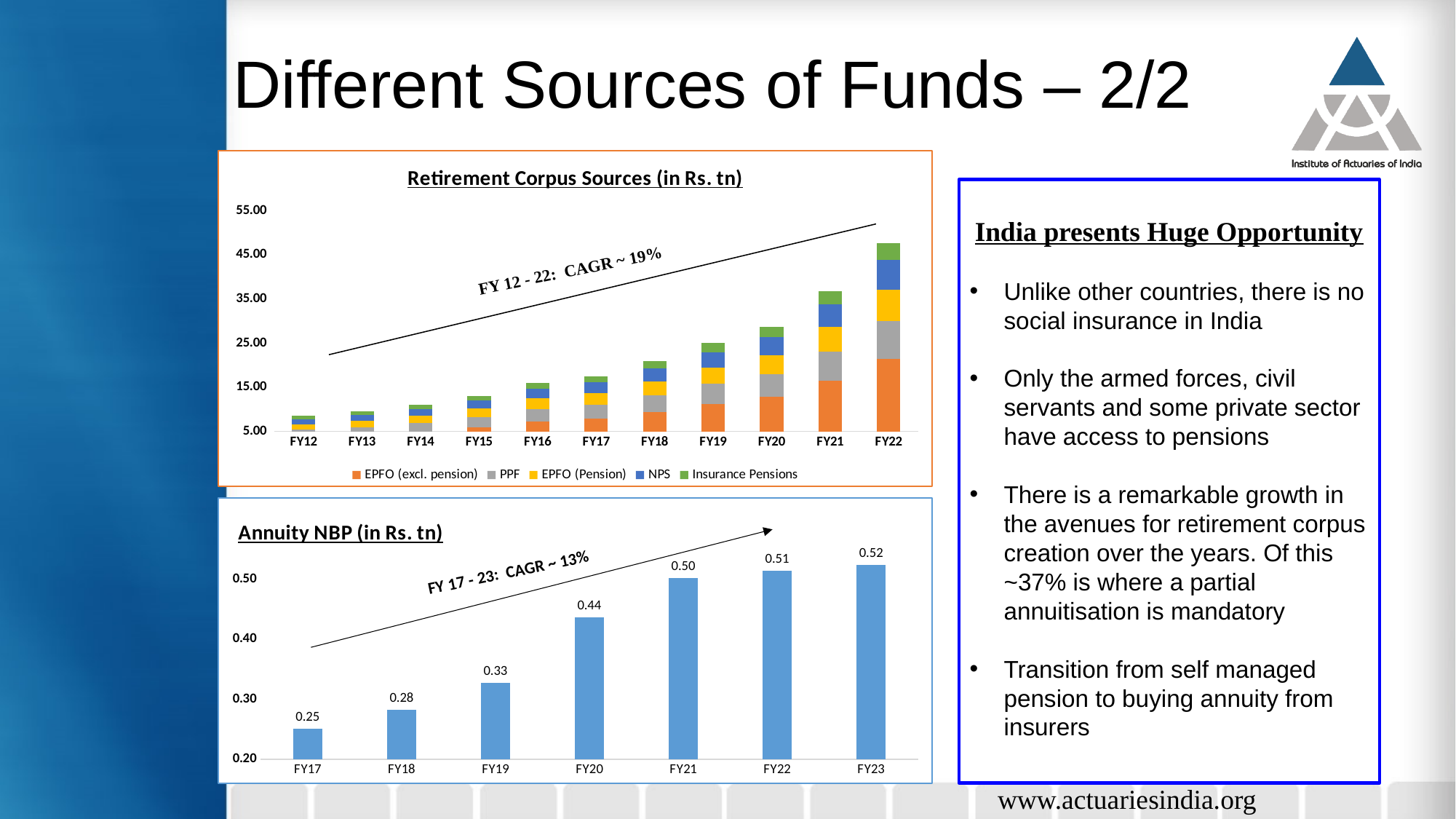
In the Retirement Corpus Sources (in Rs. tn) chart, is the total stacked value for FY22 greater or less than 35.00? greater How many fiscal years are shown on the x axis of the Retirement Corpus Sources (in Rs. tn) chart? 11 In the Annuity NBP (in Rs. tn) chart, which fiscal year has the highest value? FY23 In the Annuity NBP (in Rs. tn) chart, which fiscal year has the lowest value? FY17 In the Annuity NBP (in Rs. tn) chart, what is the difference between the FY23 and FY17 values? 0.27 What type of chart is the Retirement Corpus Sources (in Rs. tn) chart? stacked bar chart How many fiscal years are shown in the Annuity NBP (in Rs. tn) chart? 7 How many series does the legend of the Retirement Corpus Sources (in Rs. tn) chart list? 5 In the Annuity NBP (in Rs. tn) chart, what is the value for FY20? 0.44 In the Annuity NBP (in Rs. tn) chart, which is larger, the value for FY19 or the value for FY20? FY20 In the Annuity NBP (in Rs. tn) chart, what is the value for FY17? 0.25 In the Annuity NBP (in Rs. tn) chart, do the values rise or fall from FY17 to FY23? rise